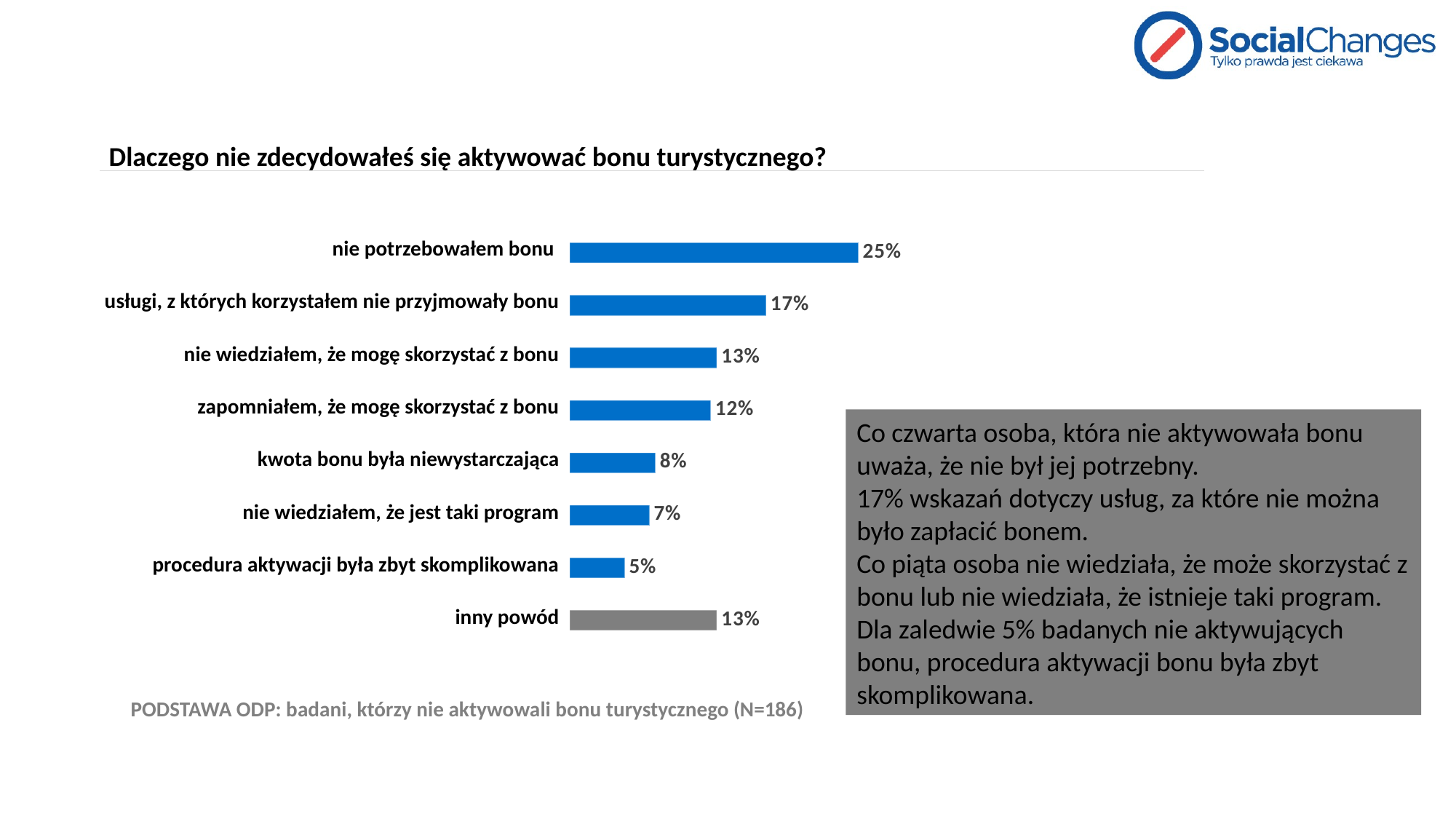
What is the value for "nie potrzebowałem bonu"? 25% Which category has the highest value? nie potrzebowałem bonu Which is larger: "zapomniałem, że mogę skorzystać z bonu" or "kwota bonu była niewystarczająca"? zapomniałem, że mogę skorzystać z bonu What is the value for "procedura aktywacji była zbyt skomplikowana"? 5% Which category has the lowest value? procedura aktywacji była zbyt skomplikowana Which category's bar is coloured grey instead of blue? inny powód What is the value for "inny powód"? 13% What kind of chart is shown on the slide? bar chart What is the value for "usługi, z których korzystałem nie przyjmowały bonu"? 17% What is the difference between "kwota bonu była niewystarczająca" and "nie wiedziałem, że jest taki program"? 1% What is the difference between "nie potrzebowałem bonu" and "usługi, z których korzystałem nie przyjmowały bonu"? 8% How many categories are shown in the chart? 8